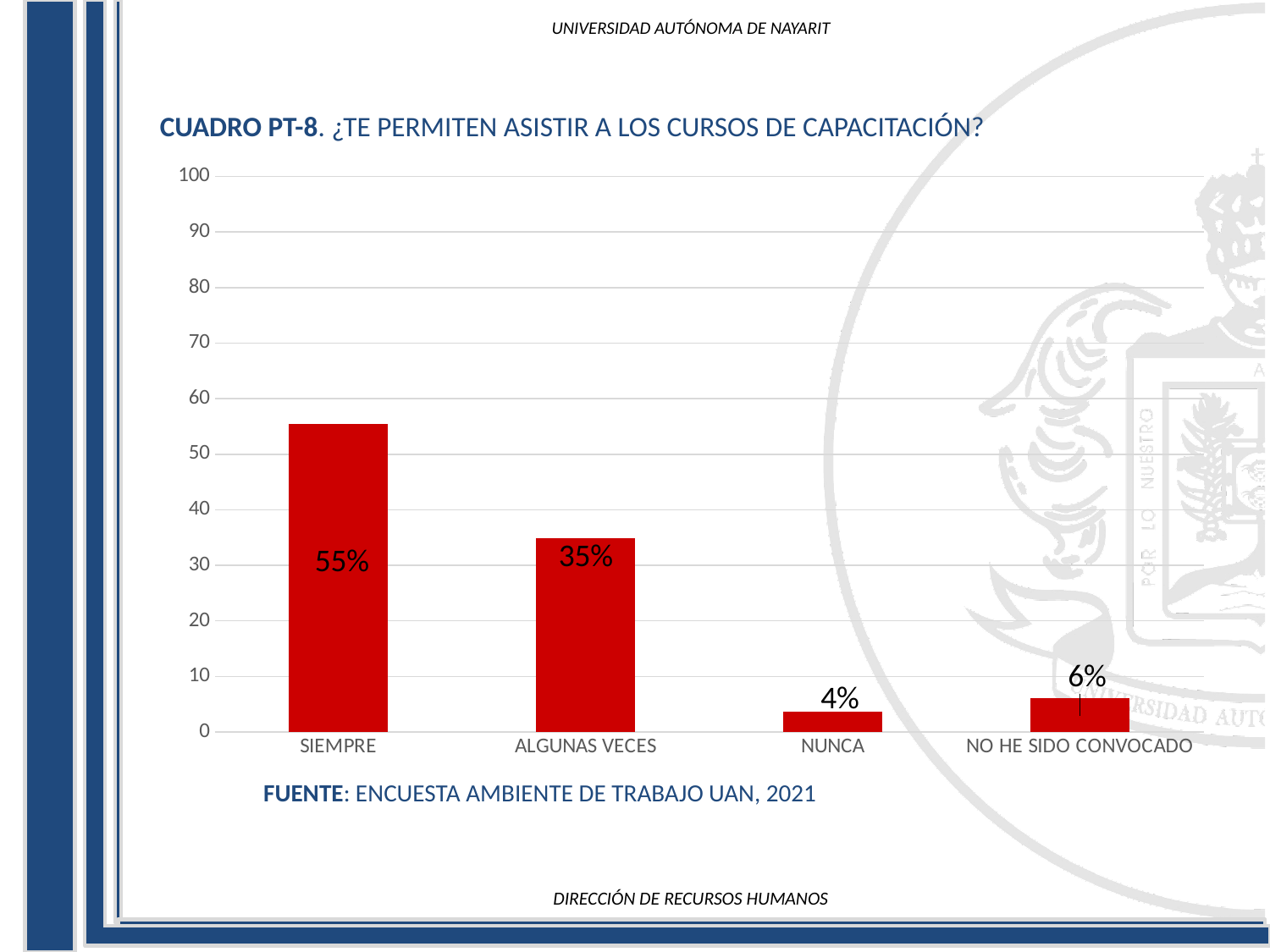
What is the value for ALGUNAS VECES? 35% What is the value for NO HE SIDO CONVOCADO? 6% Which category has the lowest value? NUNCA Which is larger, the value for NUNCA or the value for NO HE SIDO CONVOCADO? NO HE SIDO CONVOCADO What is the value for SIEMPRE? 55% What is the title of the chart? CUADRO PT-8. ¿TE PERMITEN ASISTIR A LOS CURSOS DE CAPACITACIÓN? Is the value for SIEMPRE greater or less than 50? greater How many categories are shown on the x axis? 4 What is the difference between the values for SIEMPRE and ALGUNAS VECES? 20% What kind of chart is shown on the slide? bar chart What is the value for NUNCA? 4% Which category has the highest value? SIEMPRE